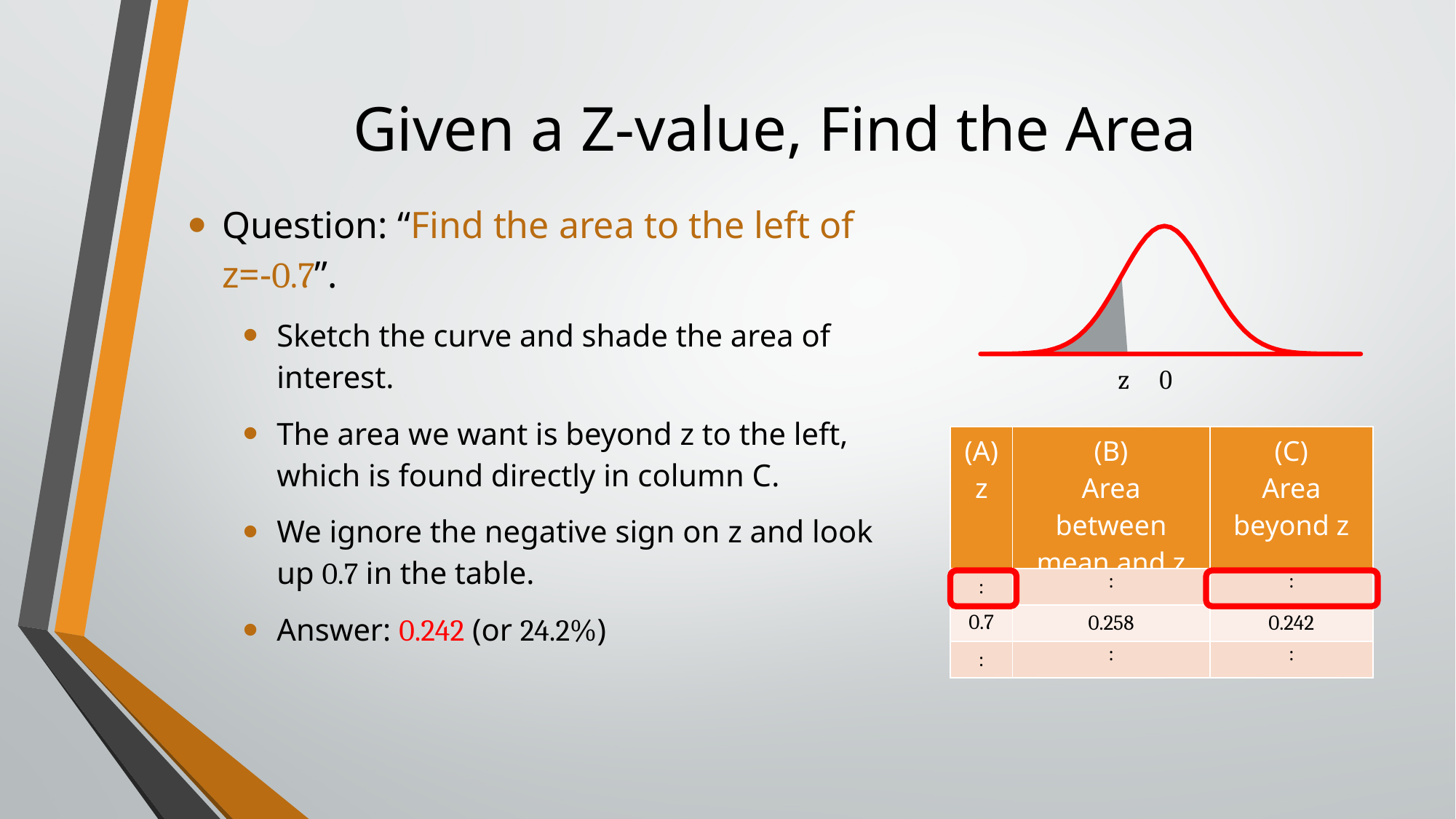
In the table, what is the difference between the area between the mean and z and the area beyond z for z = 0.7? 0.016 In the table, for z = 0.7, which is larger: the area between the mean and z, or the area beyond z? the area between the mean and z (0.258) In the table, what is the area beyond z for z = 0.7? 0.242 In the table, what is the area between the mean and z for z = 0.7? 0.258 What kind of chart is shown at the top right of the slide? a bell-shaped normal distribution curve Which column of the table is highlighted with a red outline alongside column (A)? column (C), Area beyond z What two labels appear under the horizontal axis of the curve at the top right? z and 0 How many columns does the table have? 3 On the curve at the top right, is the shaded region to the left or to the right of z? to the left